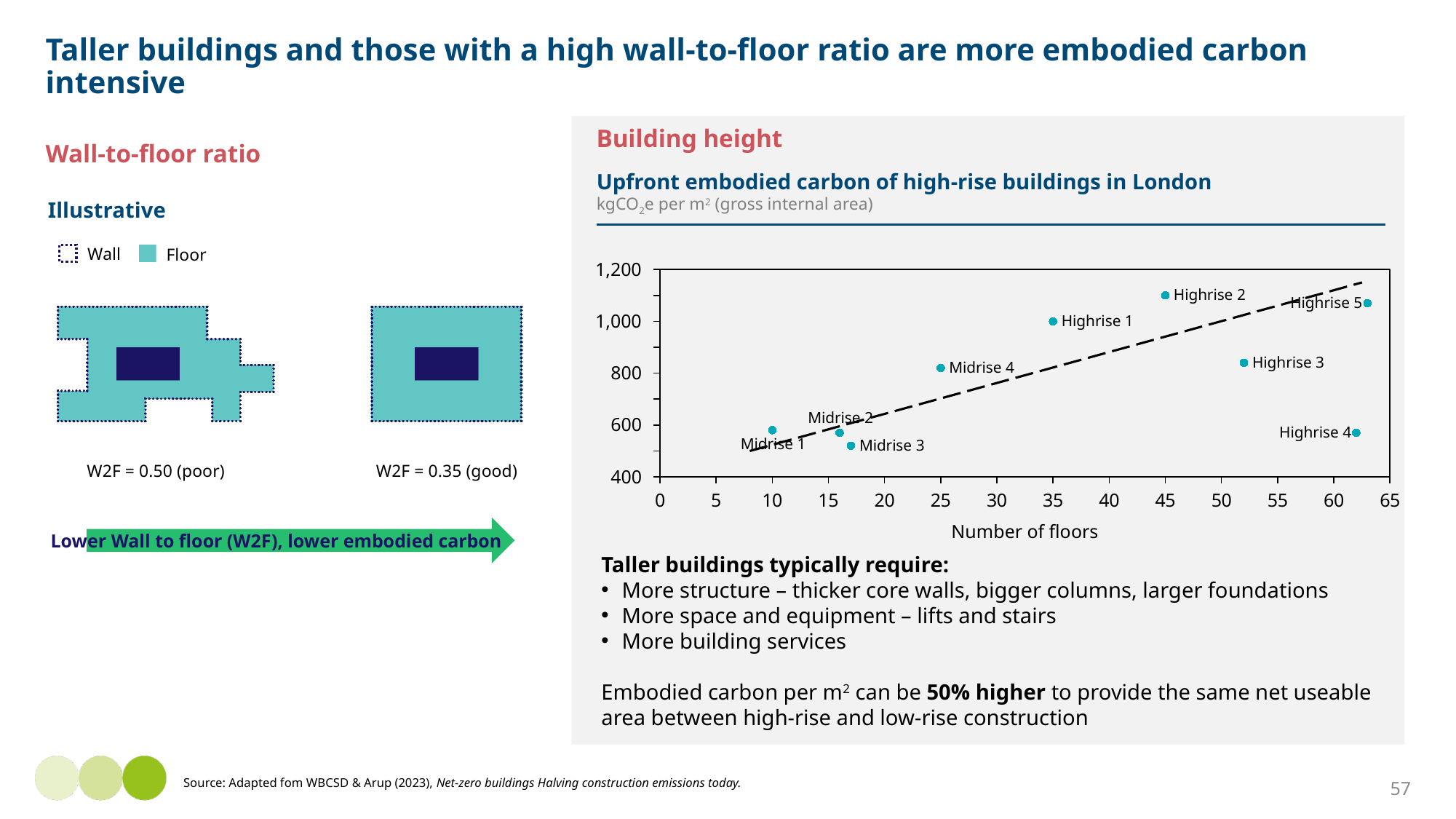
In the 'Upfront embodied carbon of high-rise buildings in London' chart, does the dashed trend line rise or fall as the number of floors increases? rise In the 'Upfront embodied carbon of high-rise buildings in London' chart, is the value for Highrise 1 greater or less than 800? greater In the 'Upfront embodied carbon of high-rise buildings in London' chart, which building has the lowest embodied carbon per m²? Midrise 3 In the 'Upfront embodied carbon of high-rise buildings in London' chart, is the value for Highrise 4 greater or less than 800? less In the 'Upfront embodied carbon of high-rise buildings in London' chart, is the value for Highrise 2 greater or less than 1,000? greater What is the x-axis label of the 'Upfront embodied carbon of high-rise buildings in London' chart? Number of floors What kind of chart is 'Upfront embodied carbon of high-rise buildings in London'? scatter chart How many buildings are plotted in the 'Upfront embodied carbon of high-rise buildings in London' chart? 9 In the 'Upfront embodied carbon of high-rise buildings in London' chart, which has the higher embodied carbon per m², Midrise 4 or Midrise 1? Midrise 4 In the 'Upfront embodied carbon of high-rise buildings in London' chart, which has the higher embodied carbon per m², Highrise 3 or Highrise 4? Highrise 3